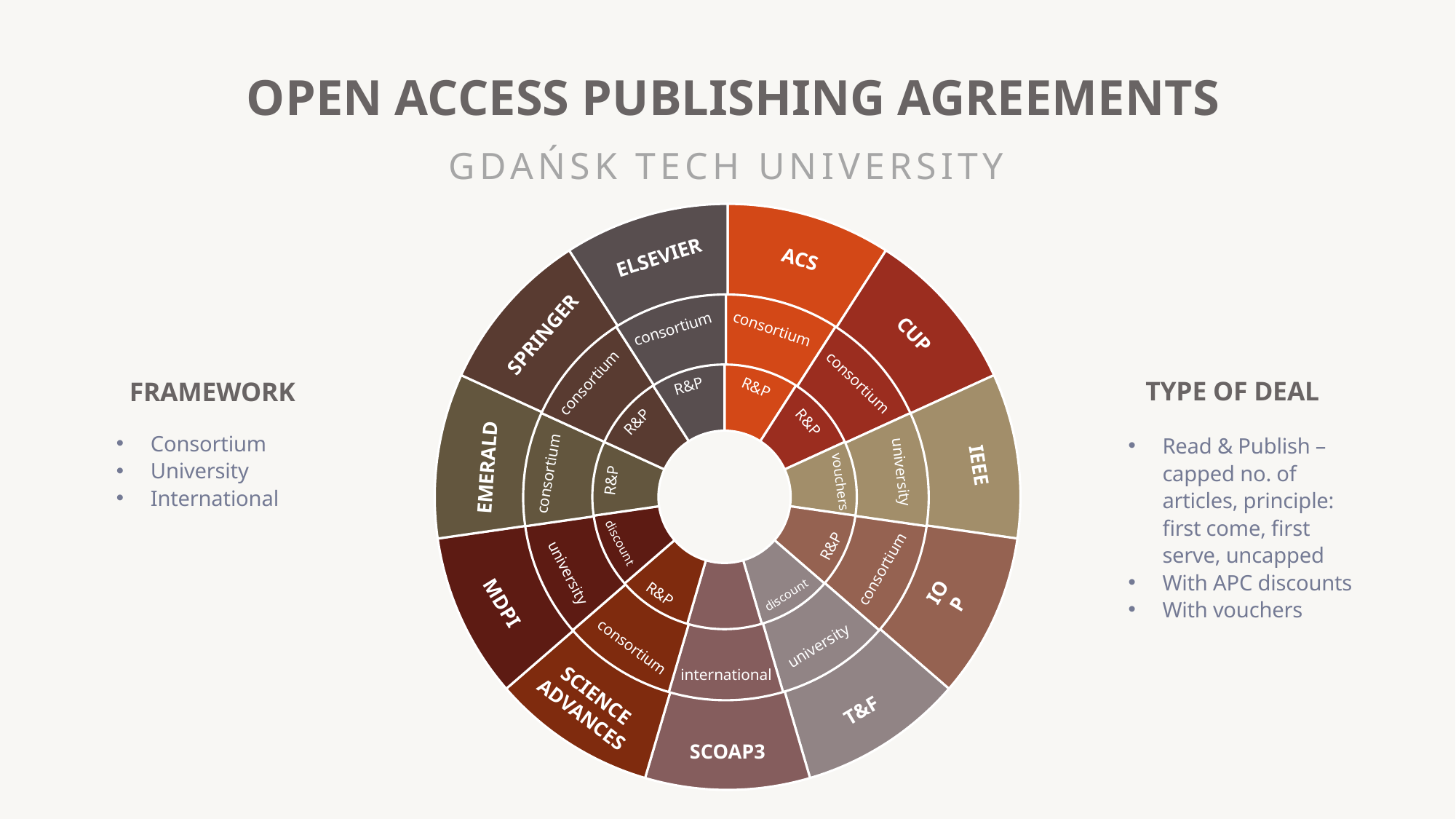
Which publisher is the only one with the 'international' framework? SCOAP3 How many rings does the chart have? 3 How many publishers are shown in the outer ring of the chart? 11 Which type of deal is shown in the inner ring for IEEE? vouchers What is the title of the slide containing the chart? OPEN ACCESS PUBLISHING AGREEMENTS How many publishers in the chart have the 'university' framework? 3 Which type of deal is shown in the inner ring for T&F? discount Which framework is shown for SCOAP3? international Which type of deal is shown in the inner ring for Elsevier? R&P Which framework is shown in the middle ring for MDPI? university Which framework is shown in the middle ring for IEEE? university What kind of chart is shown on the slide? Doughnut chart